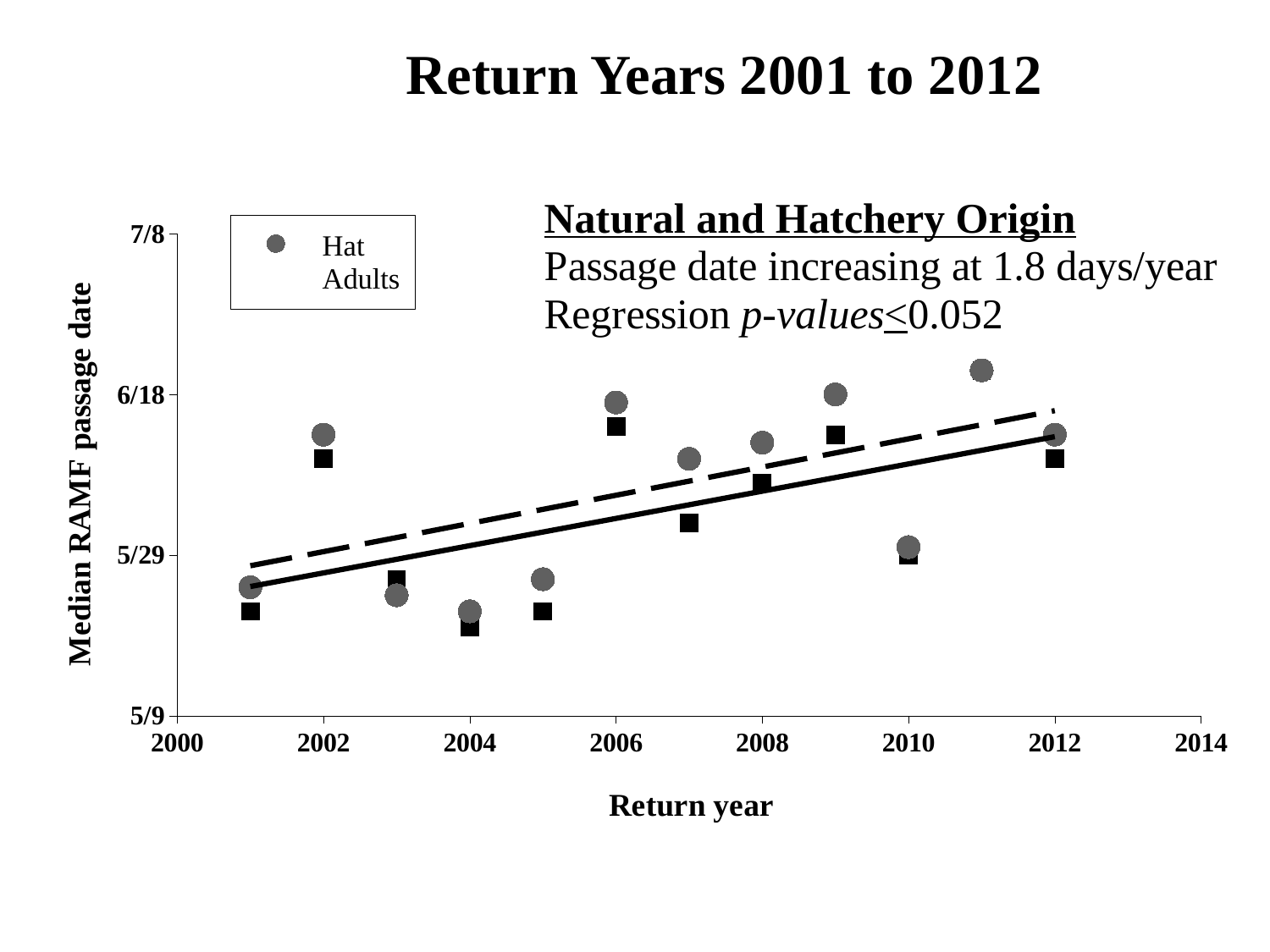
Do the Hat Adults passage dates generally rise or fall from 2001 to 2012? Rise What kind of chart is shown on the slide? Scatter plot Which return year has a later Hat Adults median passage date, 2002 or 2003? 2002 What is the title of the chart on the slide? Return Years 2001 to 2012 In which return year is the Hat Adults median passage date the earliest (lowest)? 2004 Is the Hat Adults value for 2004 greater or less than 5/29? less How many series does the legend list? 1 Is the Hat Adults value for 2011 greater or less than 6/18? greater Which return year has a later Hat Adults median passage date, 2006 or 2010? 2006 In which return year is the Hat Adults median passage date the latest (highest)? 2011 How many return years have a Hat Adults data point plotted? 12 What is the label of the y axis? Median RAMF passage date